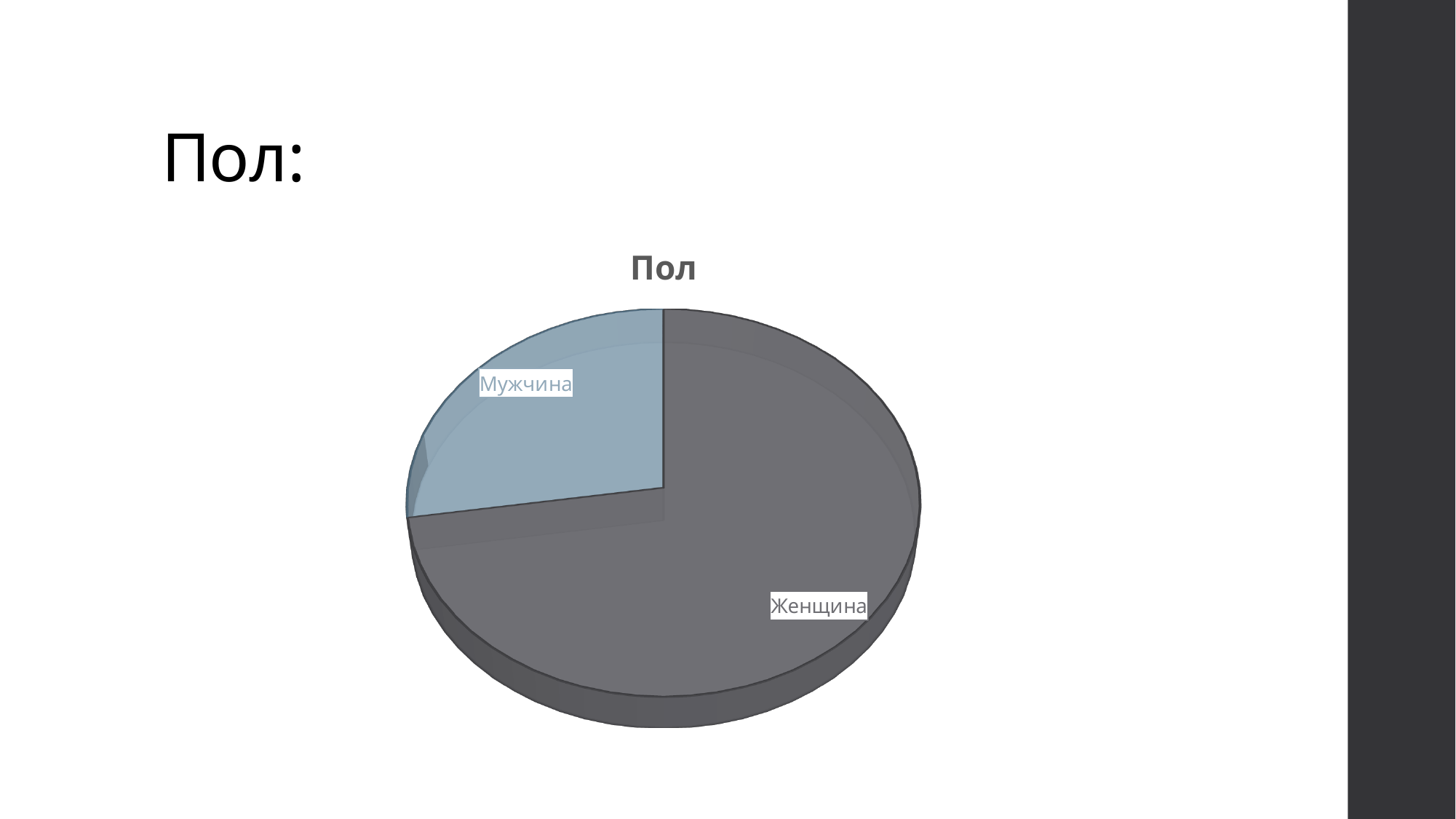
What are the labels of the two slices in the pie chart? Мужчина, Женщина What kind of chart is shown on the slide? pie chart What is the title of the chart? Пол Which slice of the pie chart is the smallest? Мужчина Which slice of the pie chart is the largest? Женщина How many slices does the pie chart have? 2 Which slice is larger, Мужчина or Женщина? Женщина